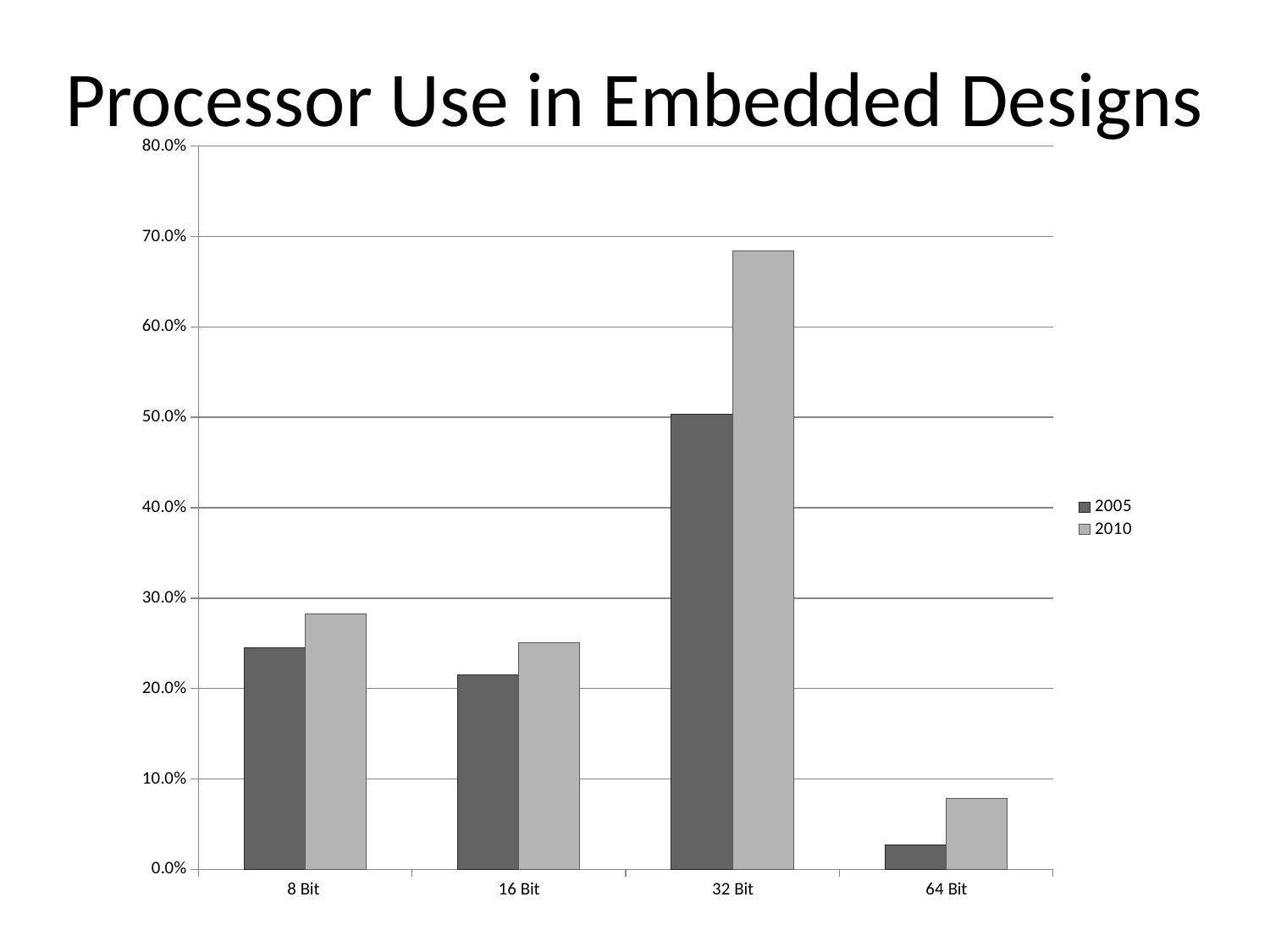
How many processor categories are shown on the x axis? 4 What kind of chart is shown on the slide? bar chart Which is larger: the 2005 value for 8 Bit or the 2005 value for 16 Bit? 8 Bit Is the 2005 value for 64 Bit greater or less than 10.0%? less Which category has the highest value for 2010? 32 Bit How many series does the legend list? 2 Is the 2010 value for 8 Bit greater or less than 30.0%? less What is the title of the chart? Processor Use in Embedded Designs Which category has the lowest value for 2005? 64 Bit Is the 2010 value for 32 Bit greater or less than 60.0%? greater For 32 Bit, which series has the larger value, 2005 or 2010? 2010